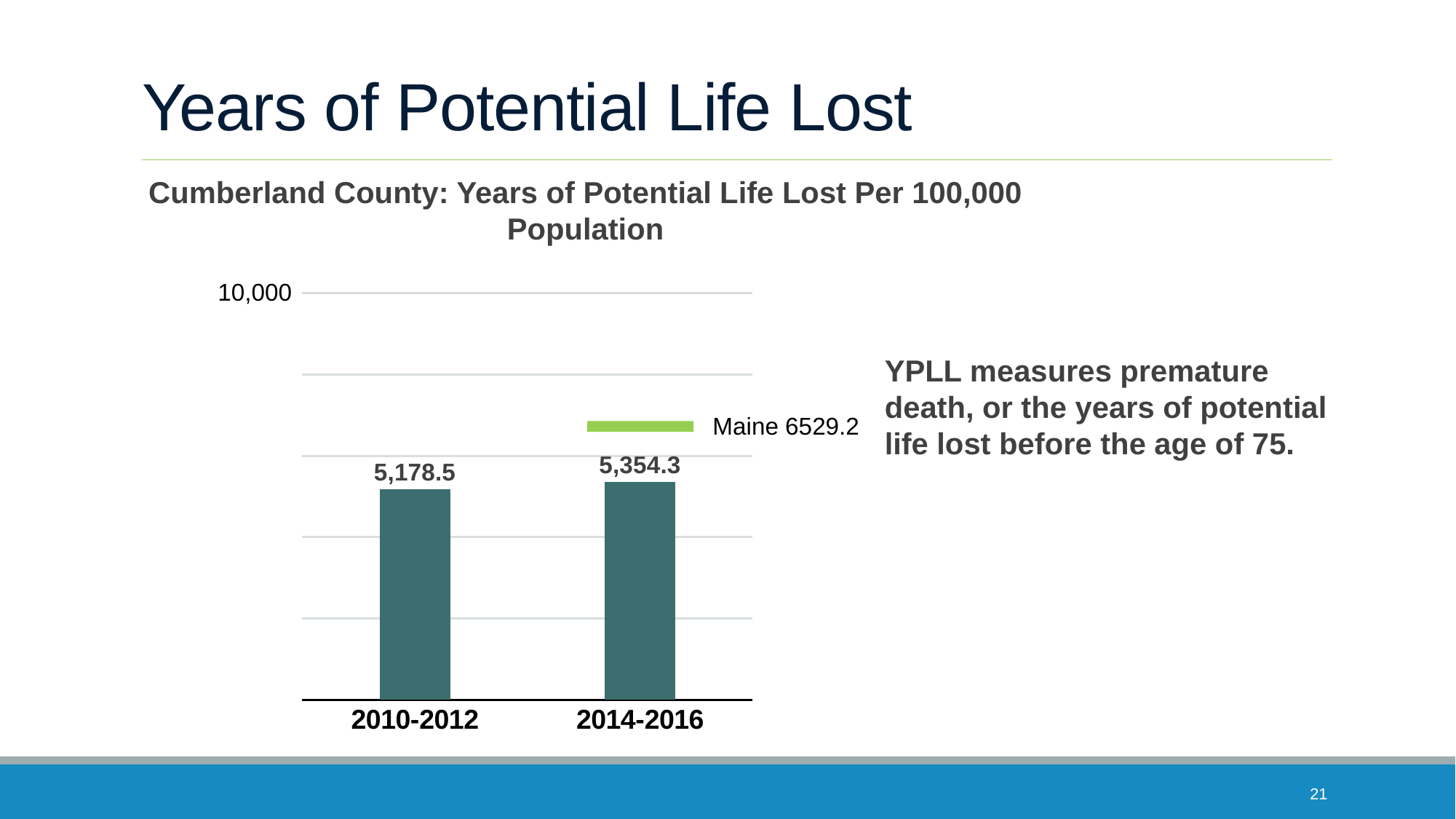
Which period has the higher value, 2010-2012 or 2014-2016? 2014-2016 What is the value for 2014-2016? 5,354.3 What is the difference between the 2014-2016 value and the 2010-2012 value? 175.8 What is the value for 2010-2012? 5,178.5 Is the value for 2014-2016 greater or less than 10,000? less Which period has the lower value? 2010-2012 How many time periods are shown on the x axis? 2 What is the title of the chart? Cumberland County: Years of Potential Life Lost Per 100,000 Population What kind of chart is shown on the slide? bar chart What is the Maine value shown on the chart? 6529.2 Is the Maine value larger or smaller than the 2014-2016 Cumberland County value? larger How much higher is the Maine value than the 2014-2016 value for Cumberland County? 1174.9